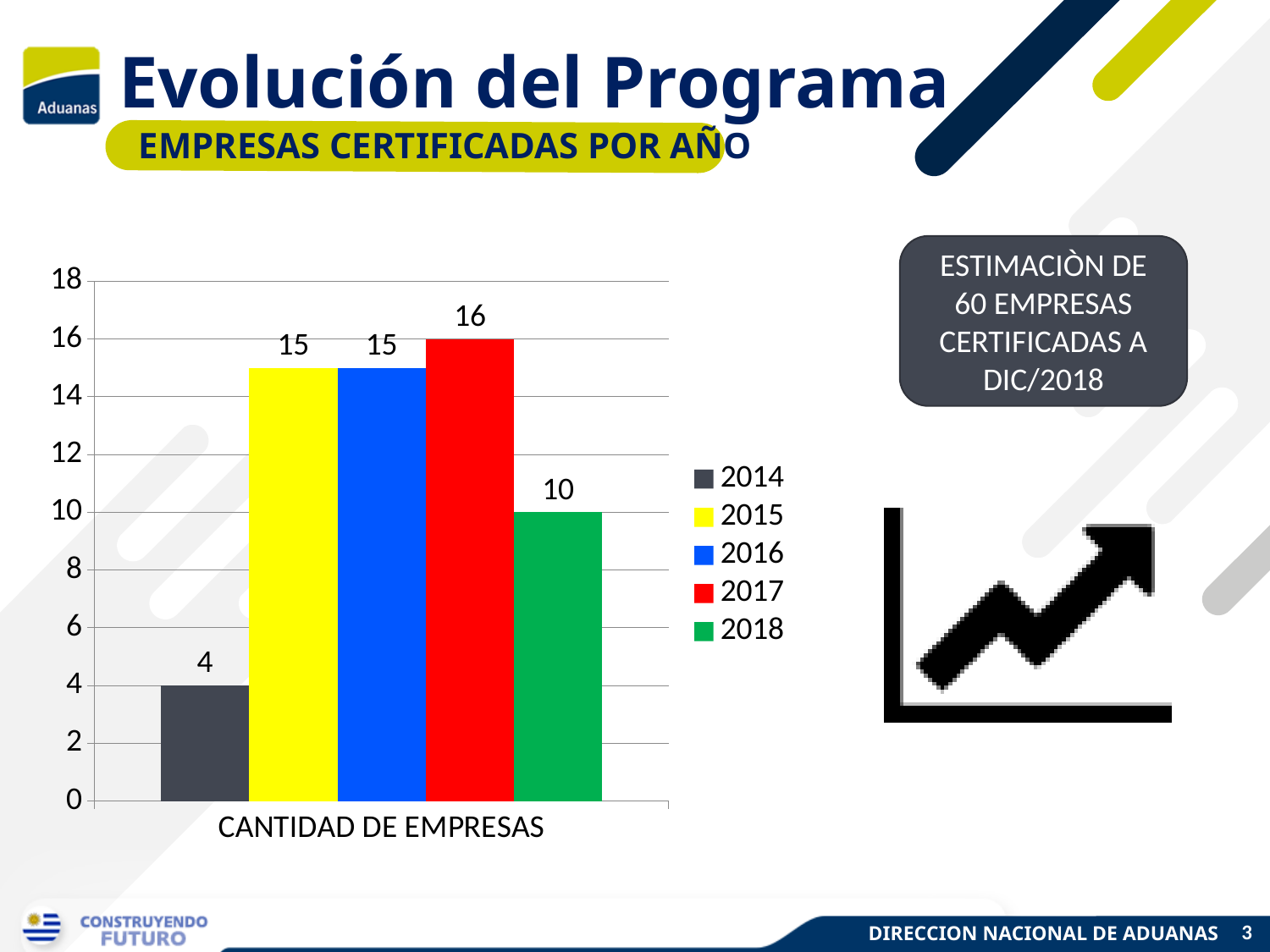
Which is larger, the value for 2016 or the value for 2018? 2016 What is the value for 2014 in the chart? 4 Which year has the lowest value in the chart? 2014 What is the label shown on the x axis of the chart? CANTIDAD DE EMPRESAS Which year has the highest value in the chart? 2017 What is the difference between the values for 2015 and 2014? 11 What is the value for 2018 in the chart? 10 What is the value for 2017 in the chart? 16 What is the difference between the values for 2017 and 2018? 6 How many series does the legend list? 5 What colour is the bar for 2017? red What kind of chart is shown on the slide? bar chart